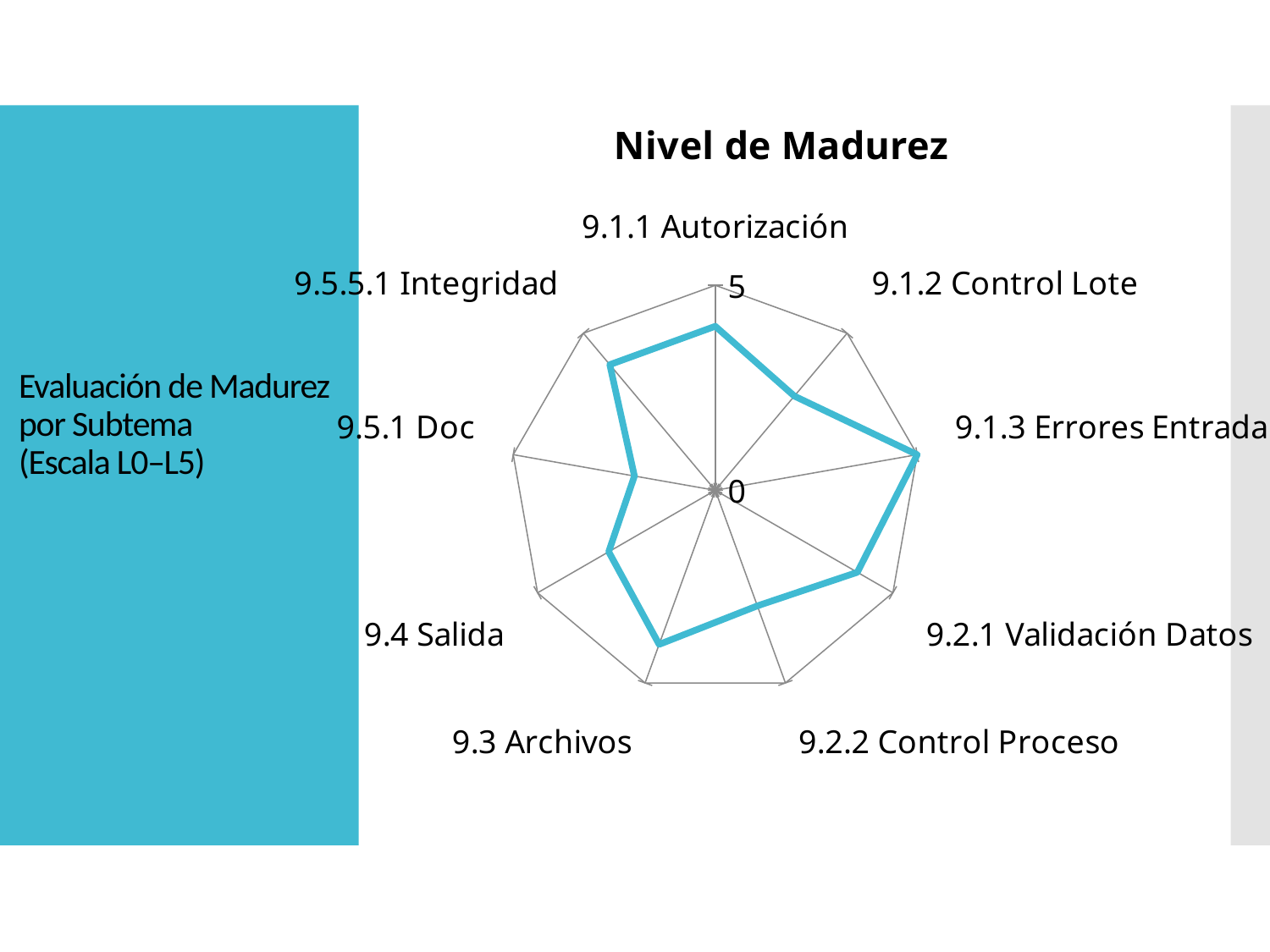
What kind of chart is shown on the slide? Radar chart Which is larger, the value for 9.1.1 Autorización or the value for 9.5.1 Doc? 9.1.1 Autorización Which is larger, the value for 9.1.3 Errores Entrada or the value for 9.5.1 Doc? 9.1.3 Errores Entrada Which category has the lowest maturity level on the chart? 9.5.1 Doc What is the value for 9.1.3 Errores Entrada? 5 Which category has the highest maturity level on the chart? 9.1.3 Errores Entrada Is the value for 9.5.1 Doc greater or less than 5? less What is the maximum value shown on the chart's axis scale? 5 How many categories (subtemas) are plotted on the radar chart? 9 What is the title of the chart? Nivel de Madurez Is the value for 9.1.1 Autorización greater or less than 0? greater